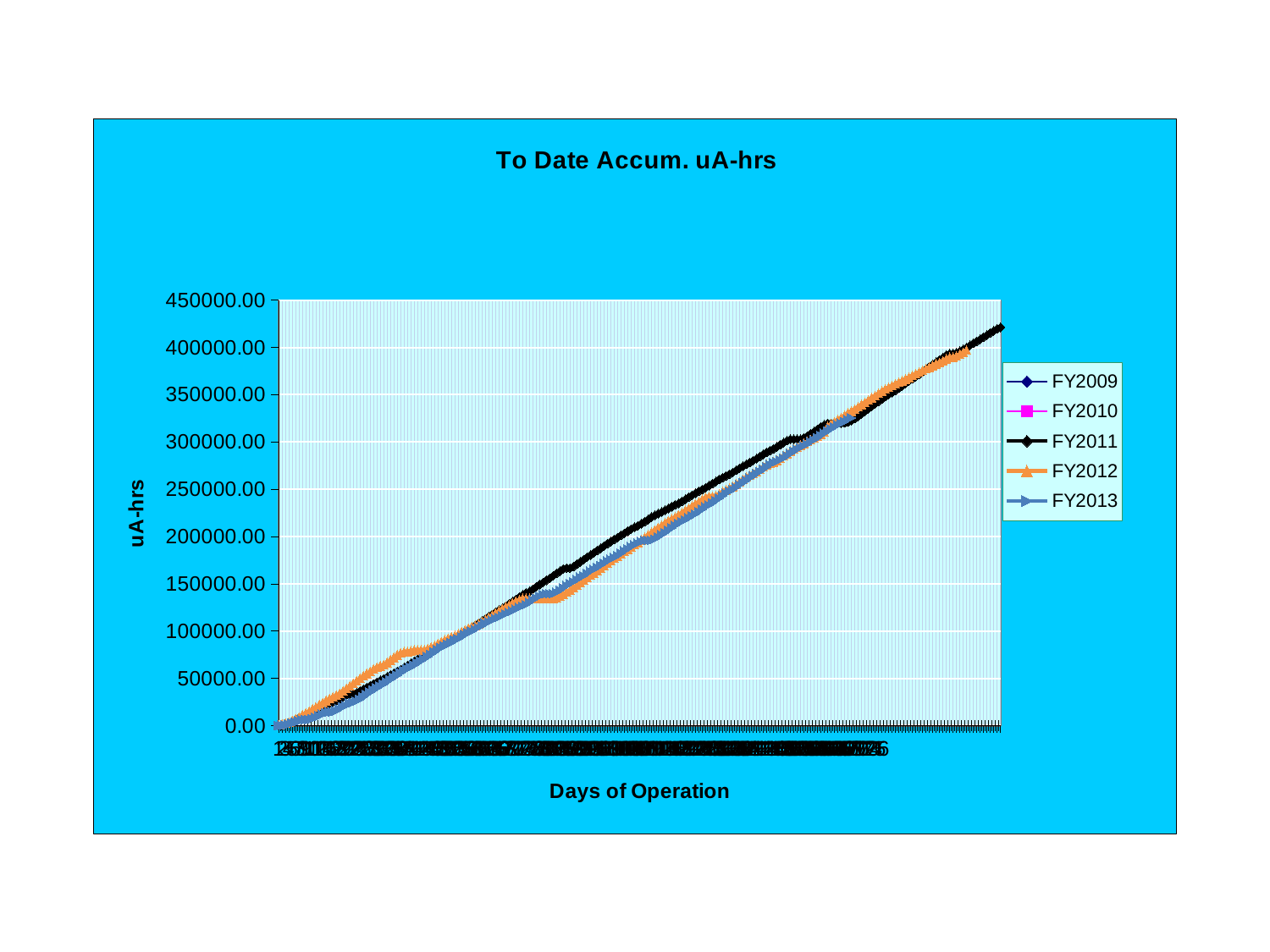
What is the label on the x axis of the chart? Days of Operation What is the lowest tick value shown on the y axis? 0.00 Which series reaches the highest accumulated uA-hrs at the end of its line? FY2011 Is the final value of the FY2013 line greater or less than 350000.00? less Do the plotted values rise or fall as the days of operation increase? rise Is the final value of the FY2011 line greater or less than 400000.00? greater How many series does the legend list? 5 What is the title of the chart? To Date Accum. uA-hrs What is the highest tick value shown on the y axis? 450000.00 What kind of chart is shown on the slide? line chart Which series ends at a higher value, FY2011 or FY2013? FY2011 Is the final value of the FY2012 line greater or less than 350000.00? greater